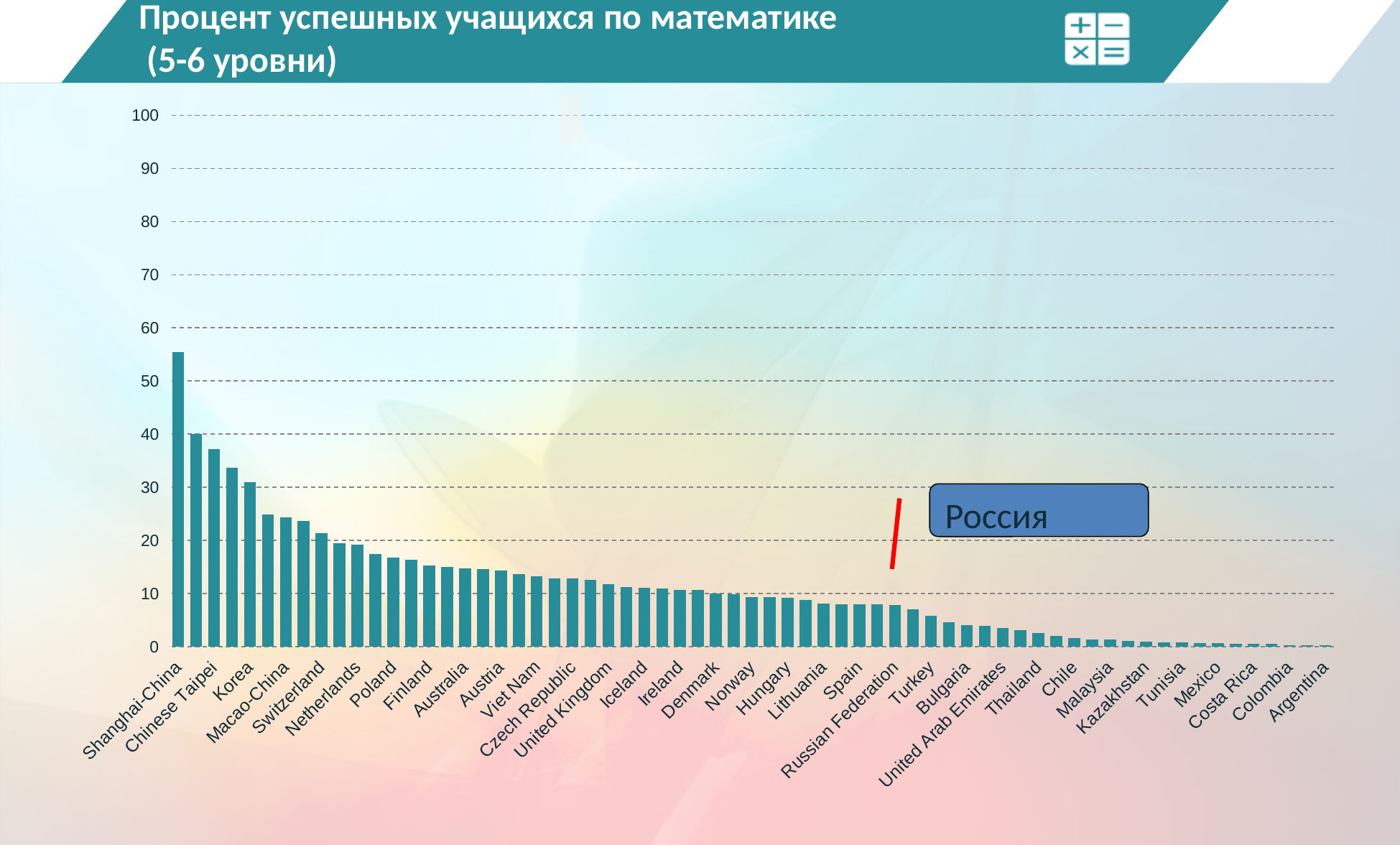
Is the value for Poland greater or less than 20? less Is the value for Turkey greater or less than 10? less Do the values rise or fall moving from left to right along the x axis? fall What text is shown in the blue callout box pointing to the Russian Federation bar? Россия Is the value for Russian Federation greater or less than 10? less Which is larger, the value for Korea or the value for Finland? Korea What kind of chart is shown on the slide? bar chart Which is larger, the value for Russian Federation or the value for Switzerland? Switzerland Which country has the highest percentage of successful students in mathematics? Shanghai-China